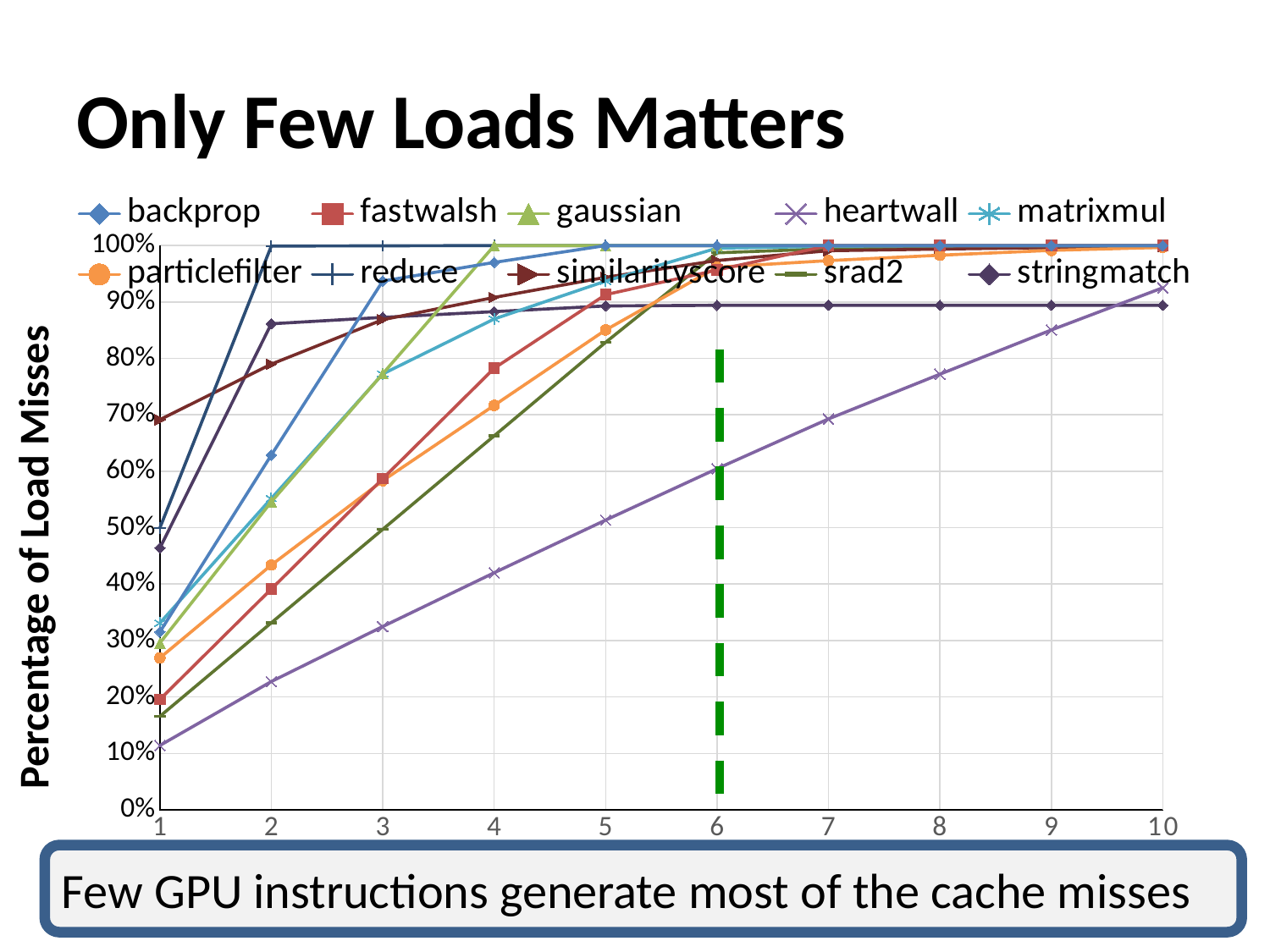
Is the value for similarityscore at x = 1 greater or less than 60%? greater Do the values for heartwall rise or fall along the x axis? rise How many series does the legend list? 10 Which series has the highest value at x = 1? similarityscore Which series has the lowest value at x = 5? heartwall Is the value for srad2 at x = 1 greater or less than 20%? less What is the title of the y axis? Percentage of Load Misses Which series has the lowest value at x = 1? heartwall At x = 3, which is larger: backprop or fastwalsh? backprop What kind of chart is shown on the slide? line chart Is the value for heartwall at x = 6 greater or less than 70%? less How many points are there along the x axis? 10